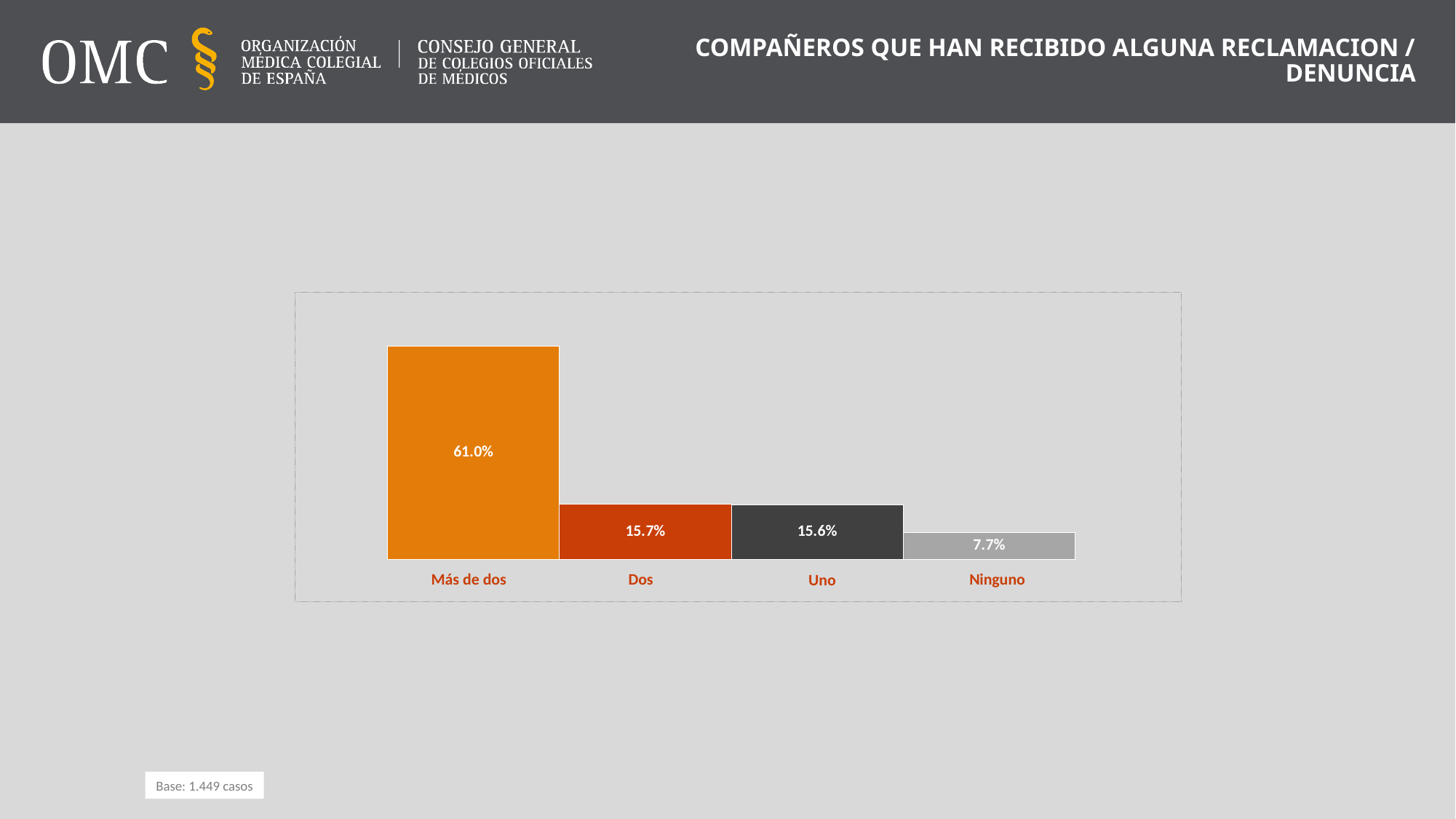
Which is larger, the value for "Más de dos" or the value for "Ninguno"? Más de dos What is the value for "Dos"? 15.7% What is the value for "Más de dos"? 61.0% Which category has the lowest value? Ninguno Which category has the highest value? Más de dos What is the value for "Uno"? 15.6% What is the difference between the values for "Uno" and "Ninguno"? 7.9% What is the value for "Ninguno"? 7.7% What is the difference between the values for "Más de dos" and "Dos"? 45.3% What is the base (number of cases) stated on the slide? 1.449 casos How many categories are shown in the chart? 4 What kind of chart is shown on the slide? Bar chart